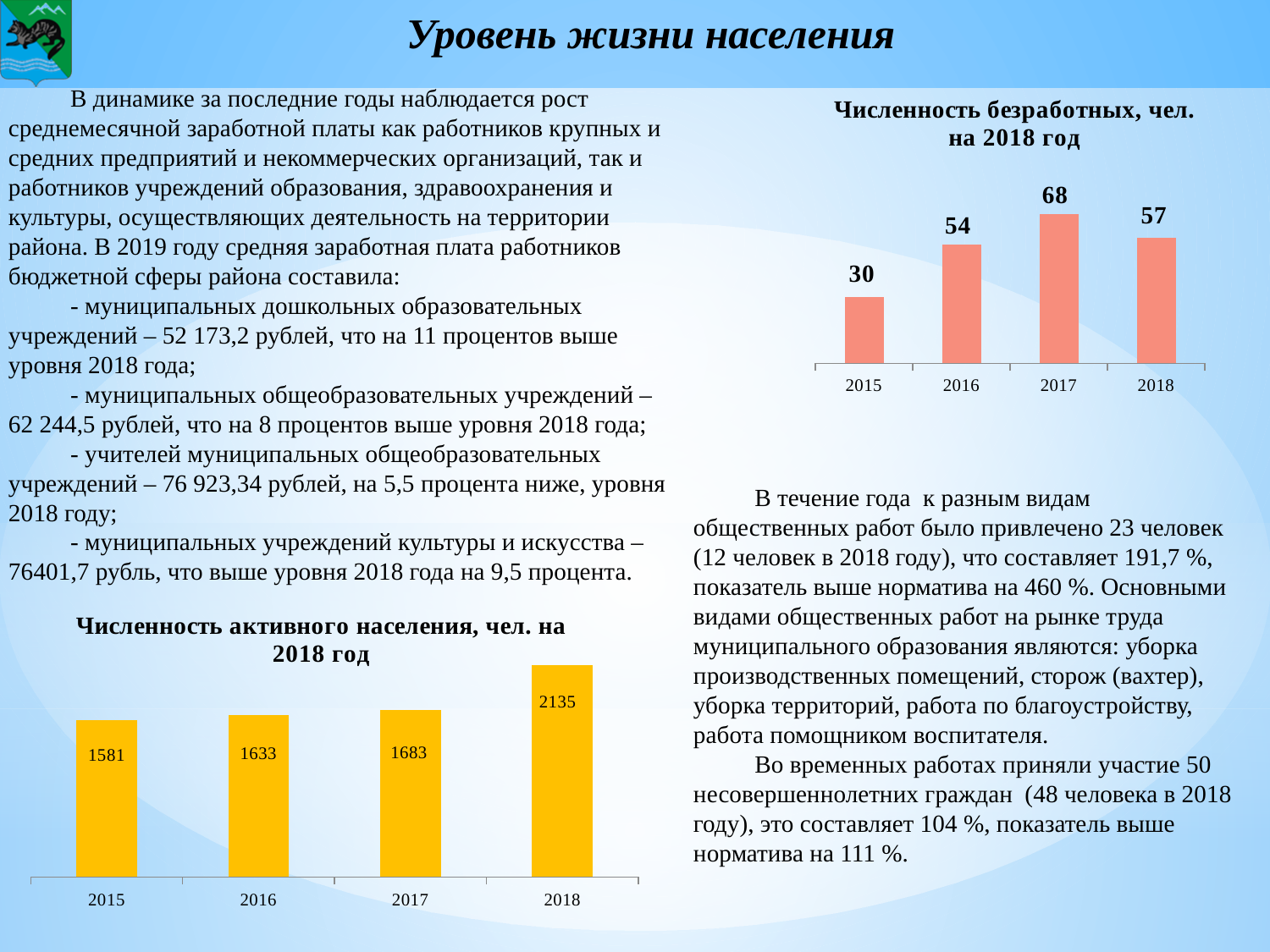
In the chart 'Численность активного населения, чел. на 2018 год', what is the value for 2016? 1633 In the chart 'Численность безработных, чел. на 2018 год', what is the difference between the values for 2017 and 2018? 11 In the chart 'Численность безработных, чел. на 2018 год', what is the value for 2017? 68 In the chart 'Численность активного населения, чел. на 2018 год', which year has the highest value? 2018 What colour are the bars in the chart 'Численность активного населения, чел. на 2018 год'? yellow In the chart 'Численность безработных, чел. на 2018 год', what is the value for 2015? 30 What kind of chart is 'Численность активного населения, чел. на 2018 год'? bar chart In the chart 'Численность активного населения, чел. на 2018 год', do the values rise or fall from 2015 to 2018? rise In the chart 'Численность безработных, чел. на 2018 год', which year has the lowest value? 2015 In the chart 'Численность безработных, чел. на 2018 год', how many years are shown? 4 In the chart 'Численность безработных, чел. на 2018 год', which is larger, the value for 2016 or the value for 2018? 2018 In the chart 'Численность активного населения, чел. на 2018 год', what is the difference between the values for 2018 and 2017? 452